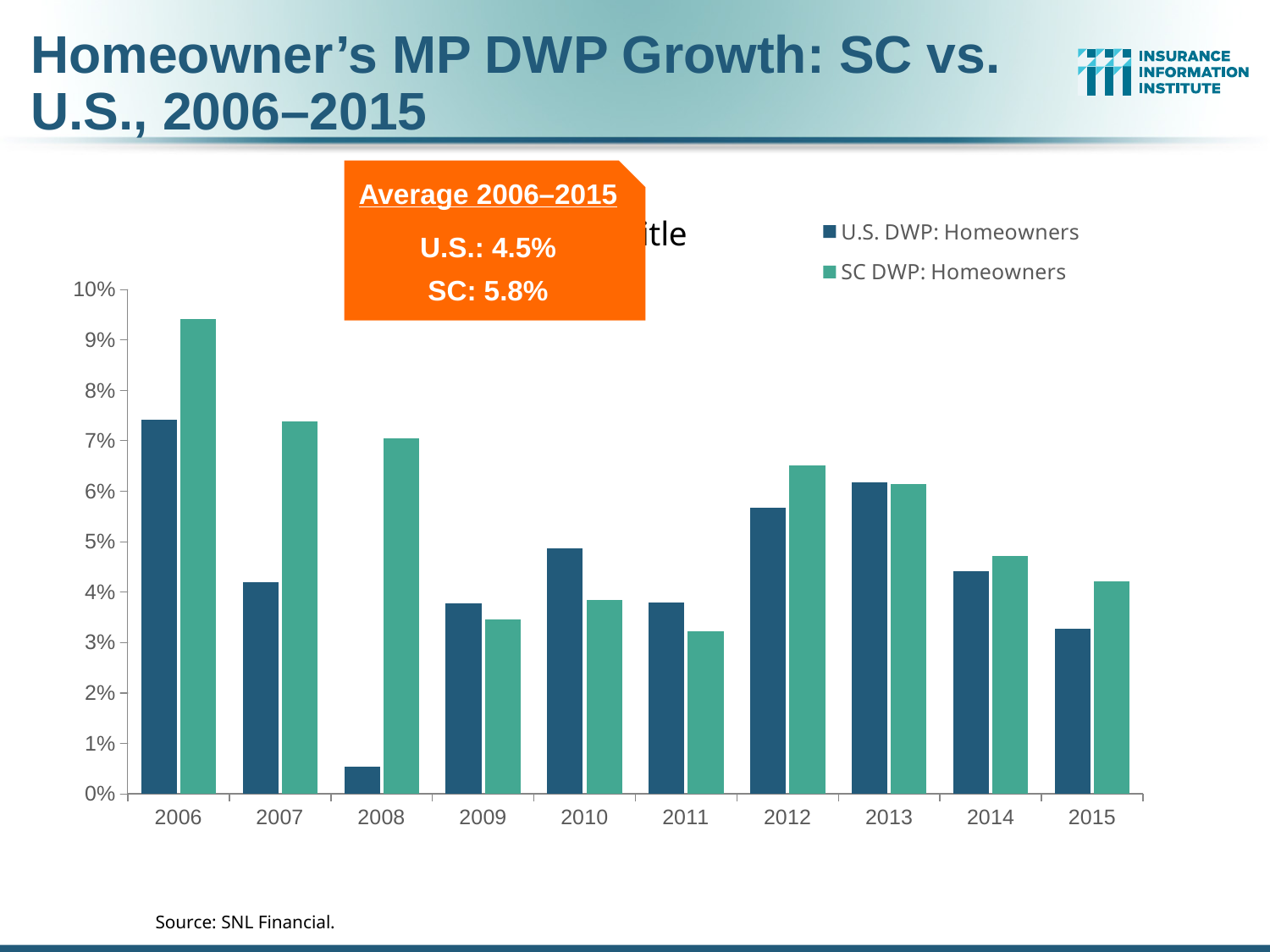
In 2010, which is larger: U.S. DWP: Homeowners or SC DWP: Homeowners? U.S. DWP: Homeowners How many series does the legend list? 2 In which year is the SC DWP: Homeowners value highest? 2006 According to the callout box, what is the average SC value for 2006–2015? 5.8% Does the U.S. DWP: Homeowners value rise or fall from 2006 to 2008? fall Is the U.S. DWP: Homeowners value for 2008 greater or less than 1%? less How many years are shown on the x axis? 10 What kind of chart is shown on the slide? bar chart In which year is the U.S. DWP: Homeowners value lowest? 2008 In which year is the U.S. DWP: Homeowners value highest? 2006 In 2008, which is larger: U.S. DWP: Homeowners or SC DWP: Homeowners? SC DWP: Homeowners Is the SC DWP: Homeowners value for 2006 greater or less than 9%? greater